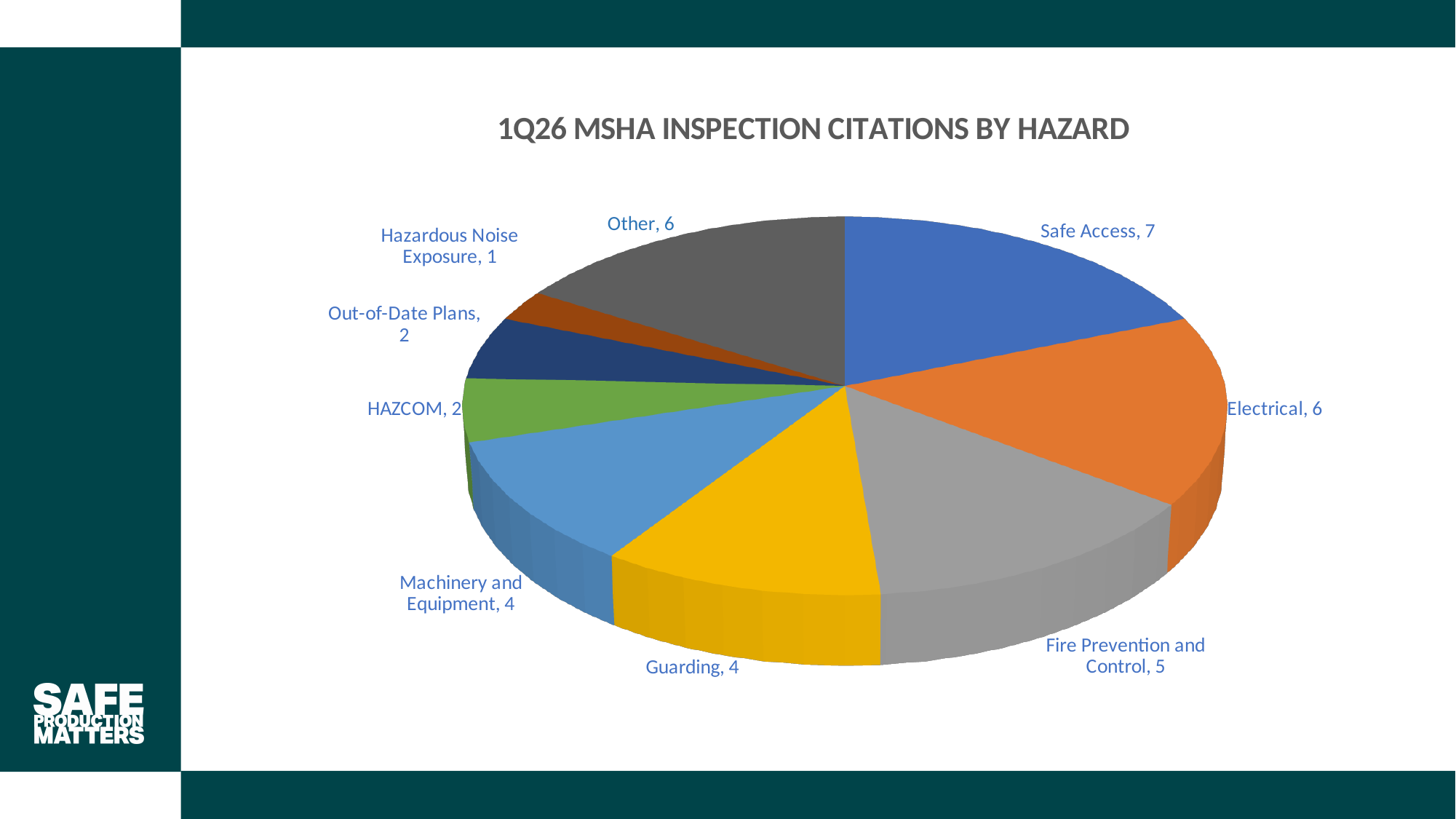
How many citations are shown for Hazardous Noise Exposure? 1 Which hazard category has the fewest citations? Hazardous Noise Exposure Which hazard category has the most citations? Safe Access Which has more citations, Electrical or Machinery and Equipment? Electrical What is the total number of citations across all hazard categories in the chart? 37 How many citations are shown for Fire Prevention and Control? 5 How many citations are shown for Safe Access? 7 What is the difference between the citations for Safe Access and Guarding? 3 What is the title of the chart? 1Q26 MSHA INSPECTION CITATIONS BY HAZARD What kind of chart is shown on the slide? Pie chart How many hazard categories are shown in the pie chart? 9 How many citations are shown for Out-of-Date Plans? 2